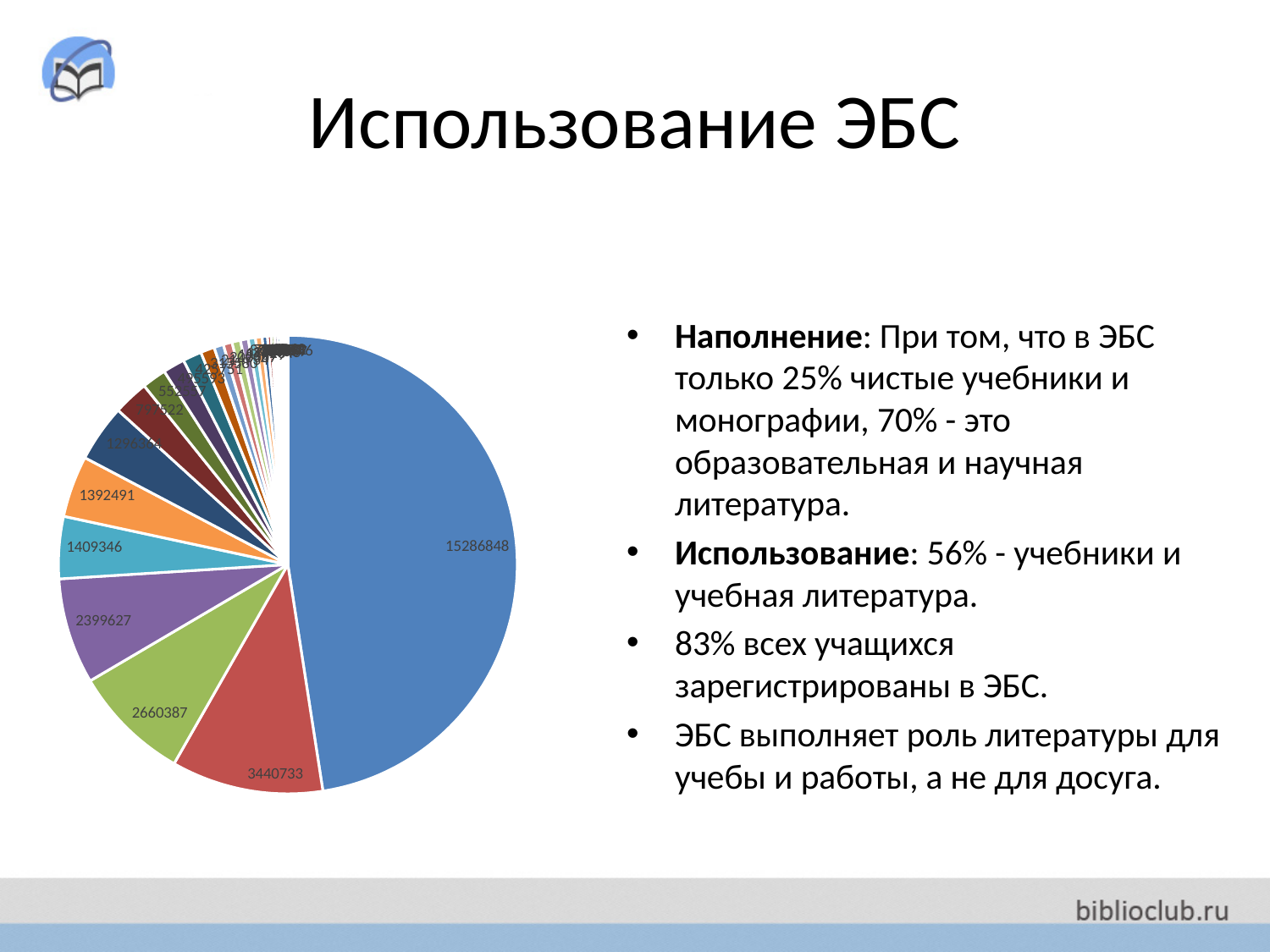
Which slice is larger in the pie chart, the red slice or the green slice? the red slice What value is labelled on the green slice of the pie chart? 2660387 What colour is the largest slice of the pie chart? blue What is the difference between the largest slice (15286848) and the red slice (3440733) in the pie chart? 11846115 What is the difference between the red slice (3440733) and the green slice (2660387) in the pie chart? 780346 What is the value of the largest slice of the pie chart? 15286848 What kind of chart is shown on the slide? pie chart Which slice is larger in the pie chart, the purple slice or the teal slice? the purple slice What value is labelled on the purple slice of the pie chart? 2399627 What value is labelled on the red slice of the pie chart? 3440733 What value is labelled on the teal (light blue) slice of the pie chart? 1409346 What value is labelled on the orange slice of the pie chart? 1392491